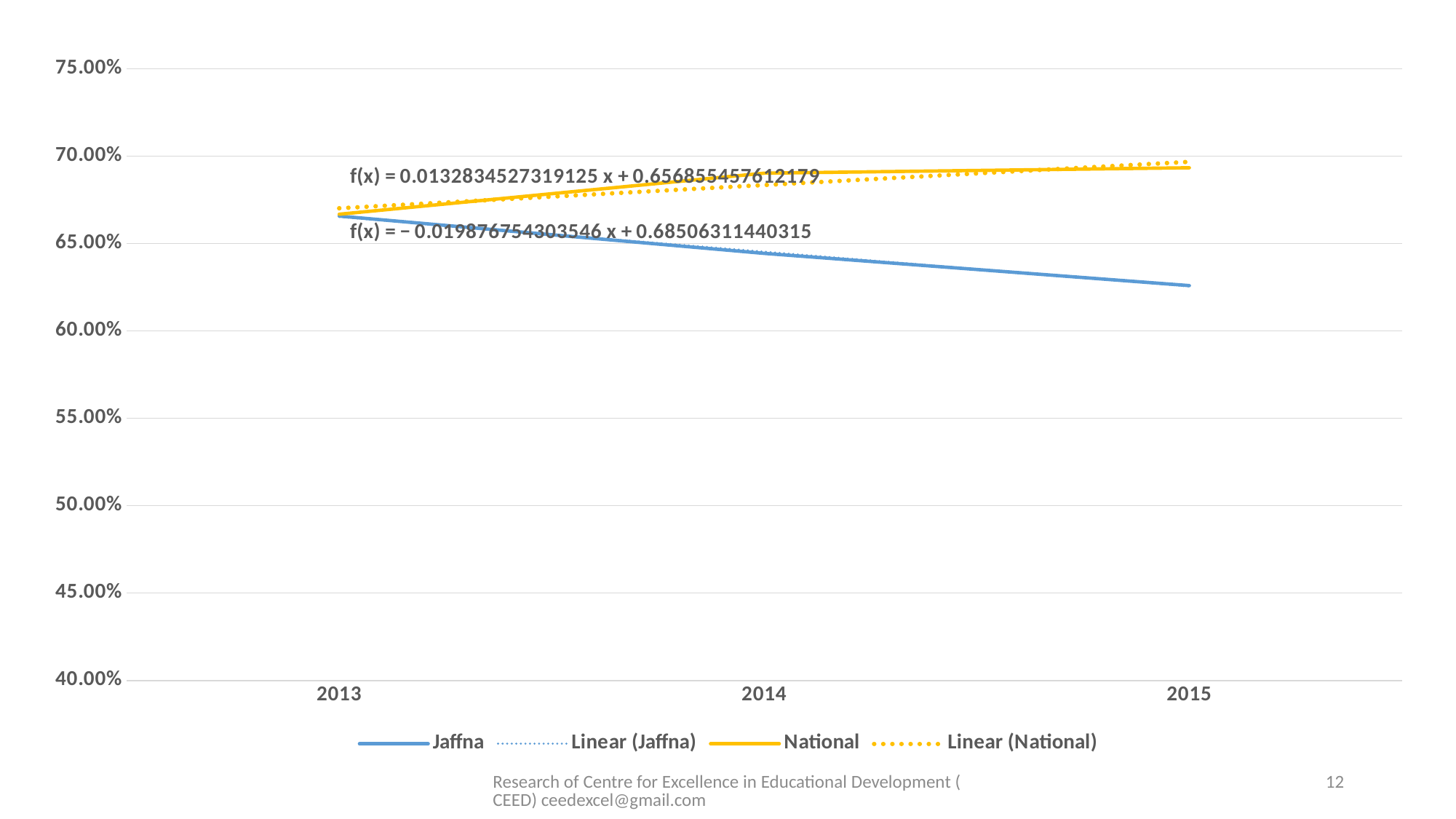
What kind of chart is shown on the slide? line chart Is the value for Jaffna in 2013 greater or less than 65.00%? greater Does the Jaffna line rise or fall from 2013 to 2015? fall In 2014, which series has the higher value, Jaffna or National? National Does the National line rise or fall from 2013 to 2015? rise How many entries does the legend list? 4 Which series is drawn in blue? Jaffna Is the value for Jaffna in 2015 greater or less than 65.00%? less In 2015, which series has the higher value, Jaffna or National? National How many years are plotted along the x axis? 3 Is the value for National in 2014 greater or less than 65.00%? greater